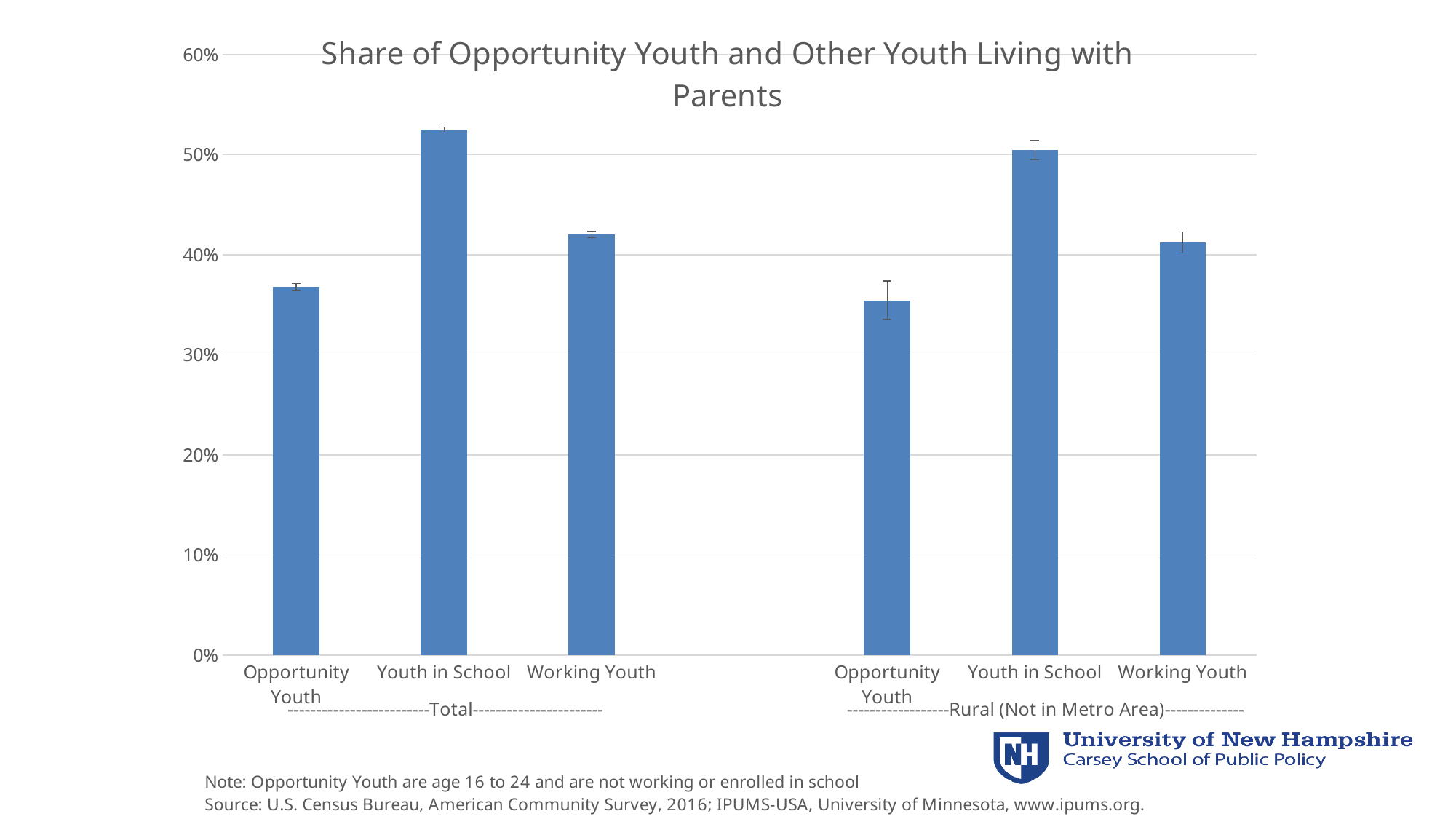
Within the Rural (Not in Metro Area) group, which category has the lowest value? Opportunity Youth How many bars are plotted in the chart? 6 In the Total group, which is larger: the value for Working Youth or the value for Opportunity Youth? Working Youth Is the value for Youth in School in the Total group greater or less than 50%? greater In the Rural (Not in Metro Area) group, which is larger: the value for Youth in School or the value for Working Youth? Youth in School Which category has the highest bar in the chart? Youth in School (Total) Is the value for Working Youth in the Rural (Not in Metro Area) group greater or less than 40%? greater Which category has the lowest bar in the chart? Opportunity Youth (Rural (Not in Metro Area)) Within the Total group, which category has the highest value? Youth in School What kind of chart is shown on the slide? bar chart What is the title of the chart? Share of Opportunity Youth and Other Youth Living with Parents Is the value for Opportunity Youth in the Total group greater or less than 40%? less